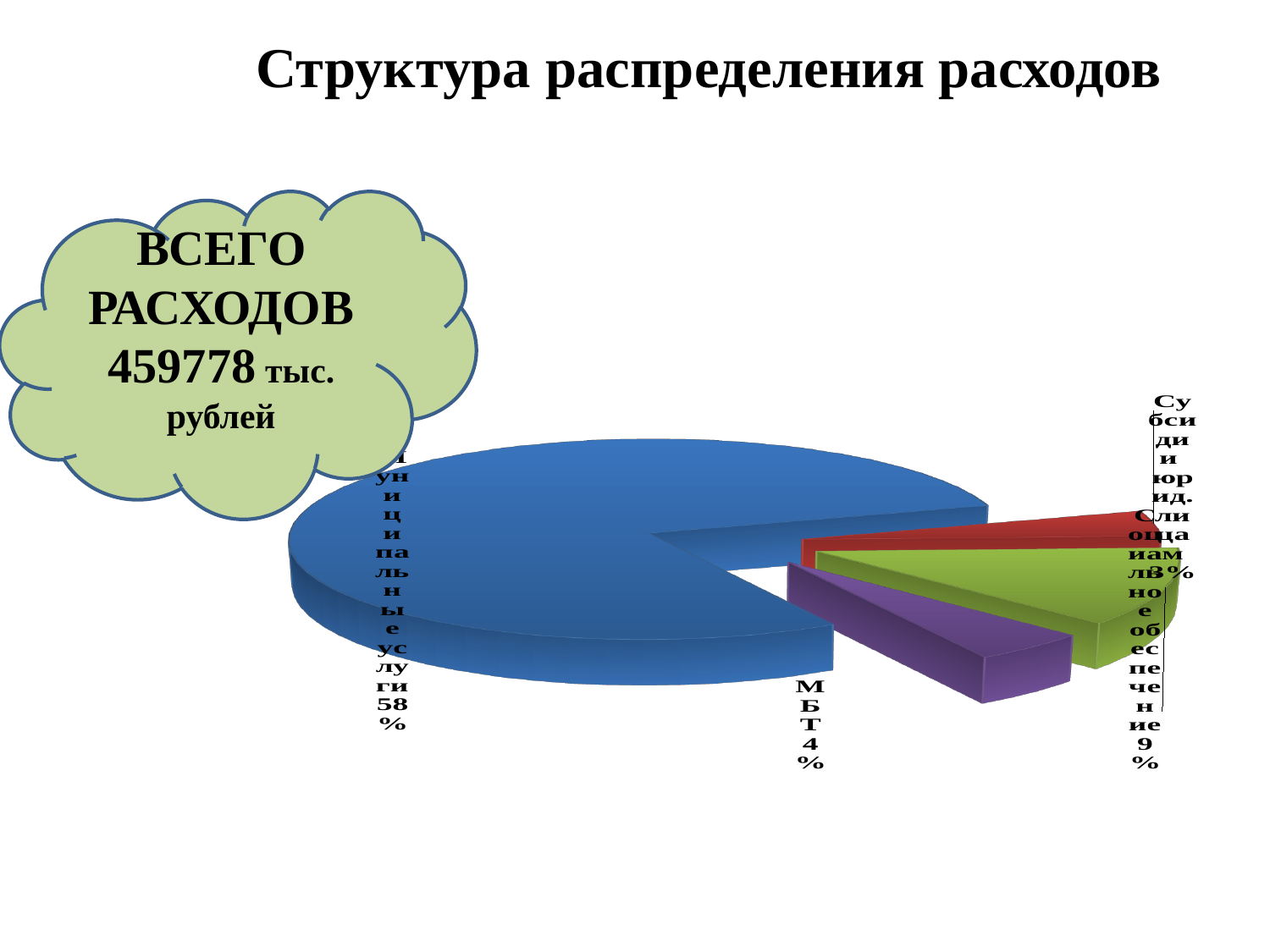
Which is larger, the share for Социальное обеспечение or the share for МБТ? Социальное обеспечение What is the title of the chart on the slide? Структура распределения расходов What share of expenses is labelled for МБТ? 4% Which category has the largest slice of the pie? Муниципальные услуги What kind of chart is shown on the slide? pie chart What total amount of expenses is stated in the cloud callout on the slide? 459778 тыс. рублей What is the difference in percentage points between Социальное обеспечение and МБТ? 5 What is the difference in percentage points between Муниципальные услуги and Социальное обеспечение? 49 What share of expenses is labelled for Муниципальные услуги? 58% How many slices does the pie chart have? 4 What share of expenses is labelled for Социальное обеспечение? 9% Is the share for Муниципальные услуги greater or less than 50%? greater